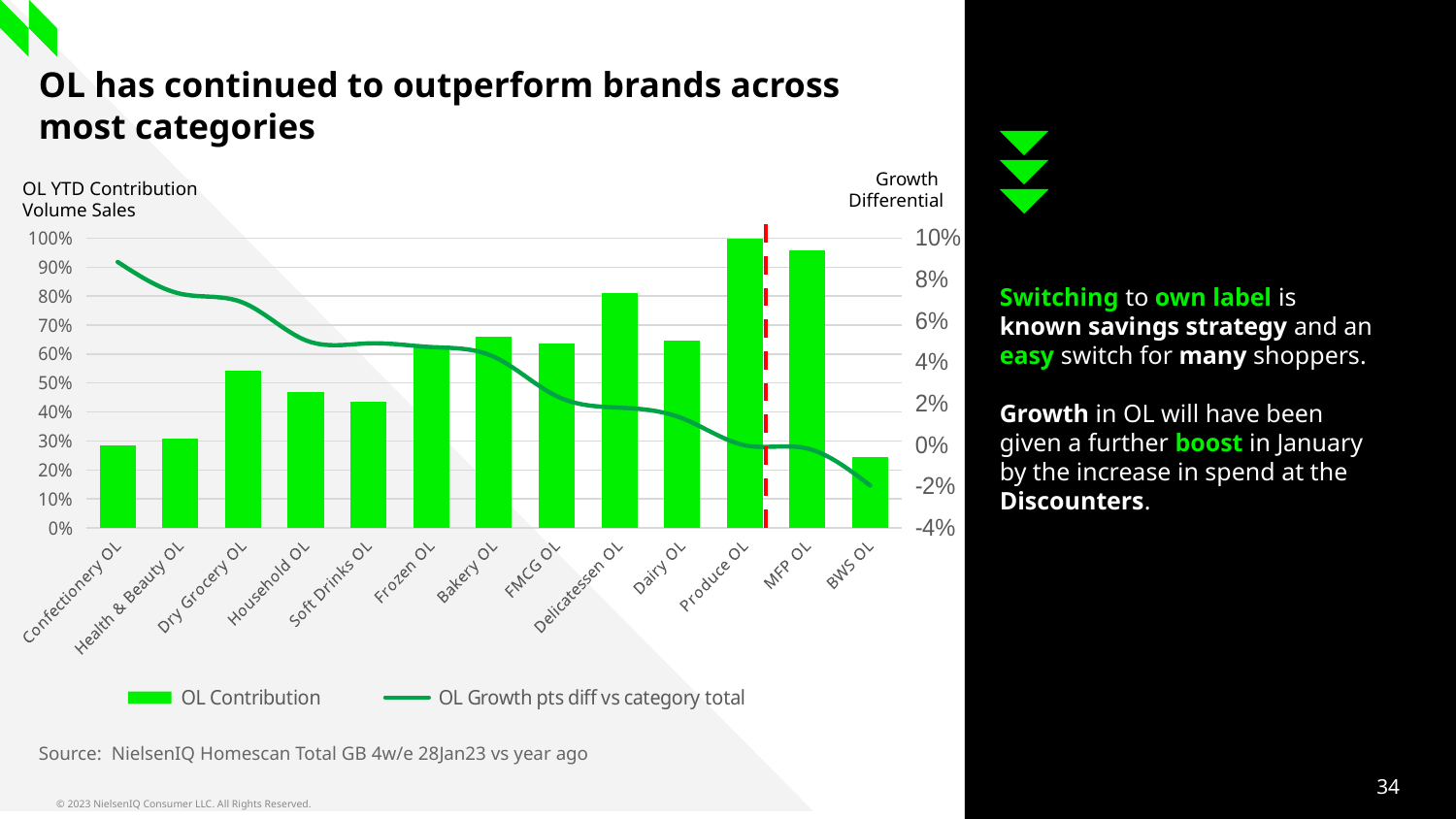
Is the OL Growth pts diff vs category total for Confectionery OL greater or less than 8%? greater What kind of chart is shown on the slide? Bar chart with a line overlay Which category has the highest OL Contribution bar? Produce OL Is the OL Growth pts diff vs category total for BWS OL greater or less than 0%? less Is the OL Contribution for Delicatessen OL greater or less than 70%? greater Does the OL Growth pts diff vs category total line generally rise or fall from left to right across the categories? fall How many series does the chart legend list? 2 What is the label of the left-hand vertical axis of the chart? OL YTD Contribution Volume Sales How many categories are shown along the x axis of the chart? 13 Which has the larger OL Contribution bar, Delicatessen OL or Dairy OL? Delicatessen OL